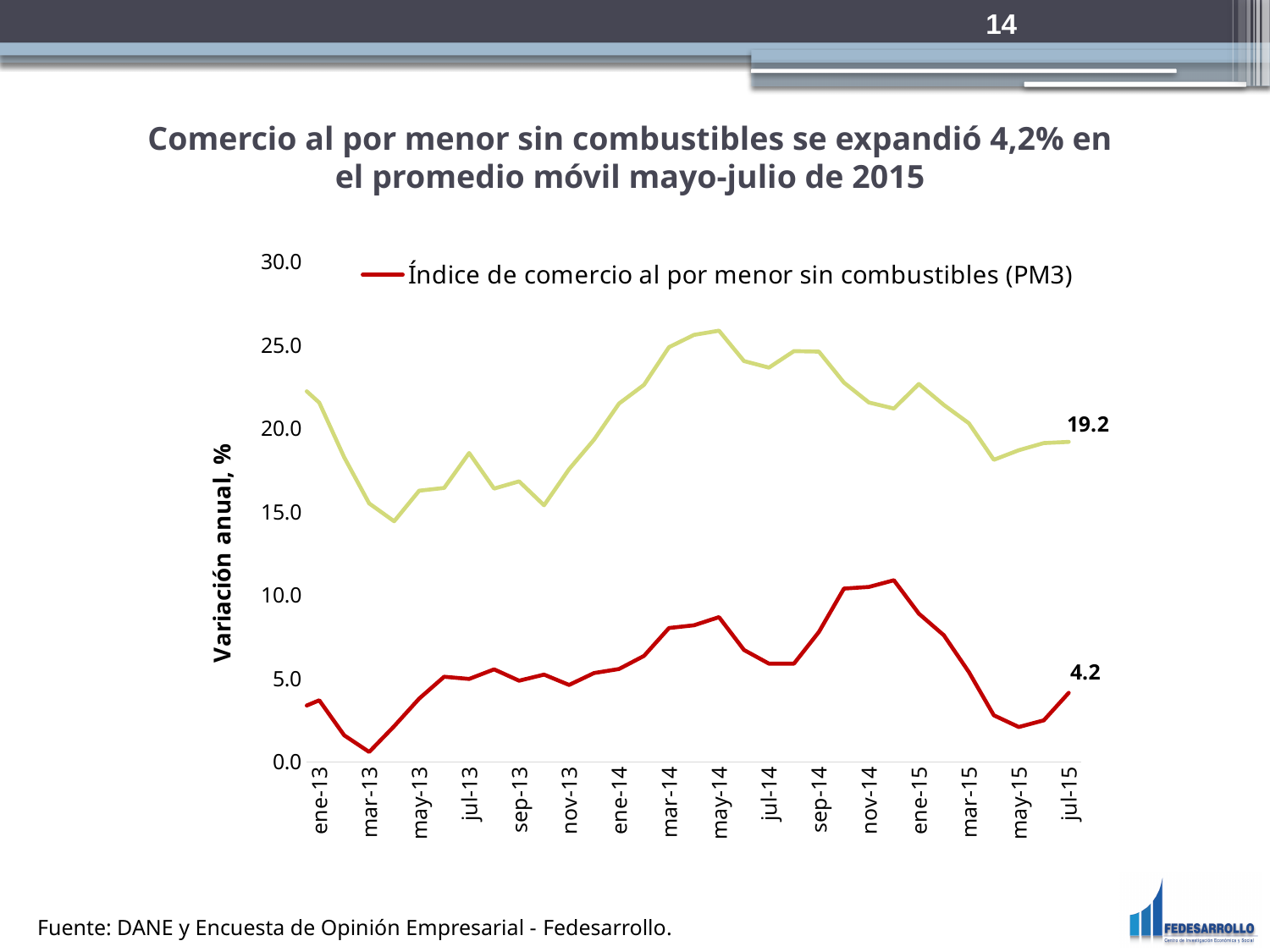
What is the title of the vertical axis? Variación anual, % Is the value of the upper light green line at mar-13 greater or less than 20.0? less At which labelled month does the red PM3 line reach its lowest value? mar-13 At jul-15, what is the difference between the upper line's labelled value and the red PM3 line's labelled value? 15.0 What is the value of the Índice de comercio al por menor sin combustibles (PM3) line at jul-15? 4.2 Is the value of the upper light green line at may-14 greater or less than 20.0? greater What kind of chart is shown on the slide? line chart Is the value of the red PM3 line at nov-14 greater or less than 5.0? greater Does the red PM3 line rise or fall between nov-14 and may-15? fall At jul-15, which line has the larger value: the red PM3 line or the upper light green line? the upper light green line What value is labelled at jul-15 on the upper (light green) line? 19.2